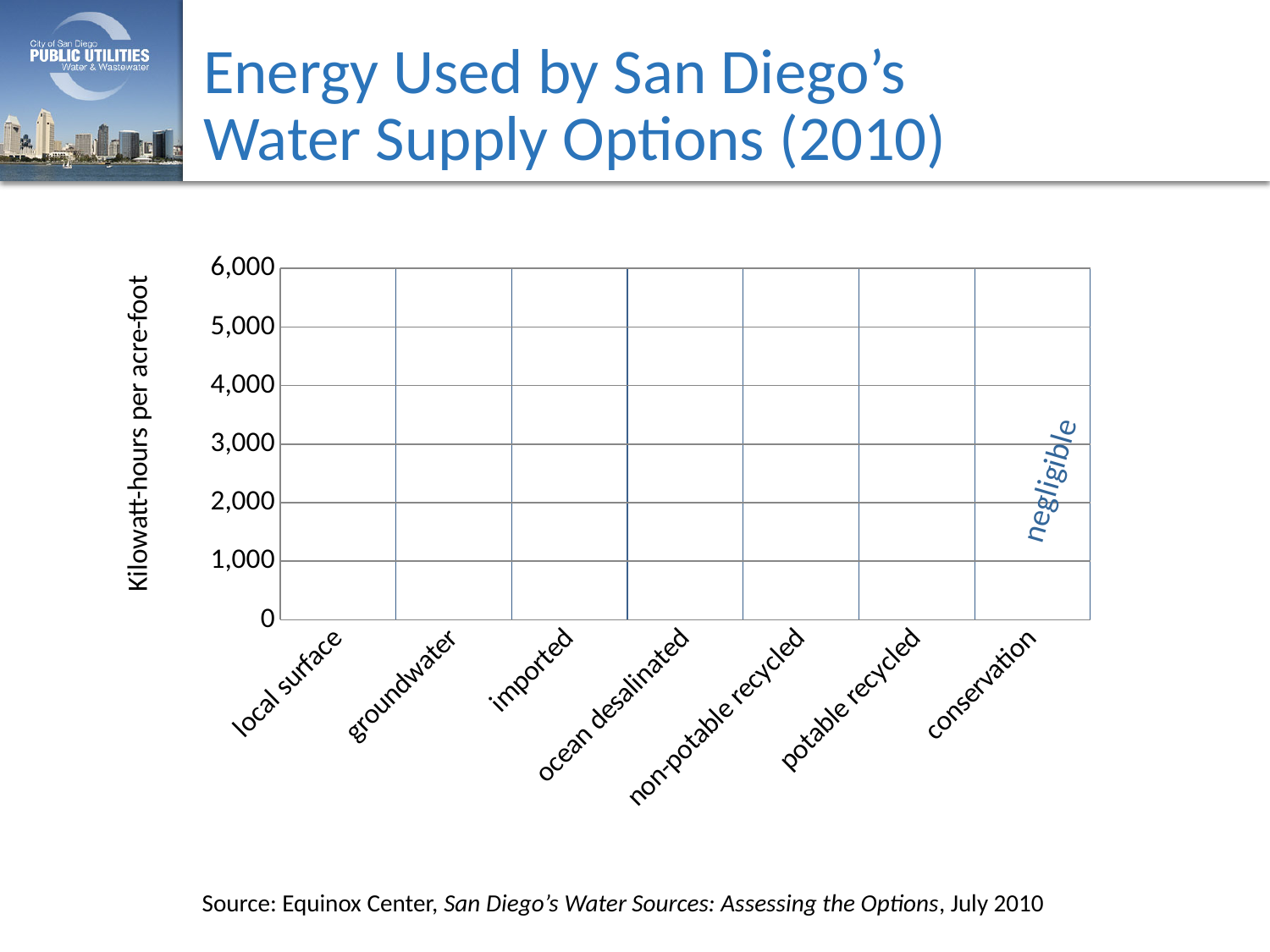
Which category on the chart is annotated with the word "negligible"? conservation What is the fourth category listed on the x axis of the chart? ocean desalinated What is the last category listed on the x axis of the chart? conservation How many water supply options are listed along the x axis of the chart? 7 What is the first category listed on the x axis of the chart? local surface What is the highest value shown on the vertical axis of the chart? 6,000 What is the label on the vertical axis of the chart? Kilowatt-hours per acre-foot